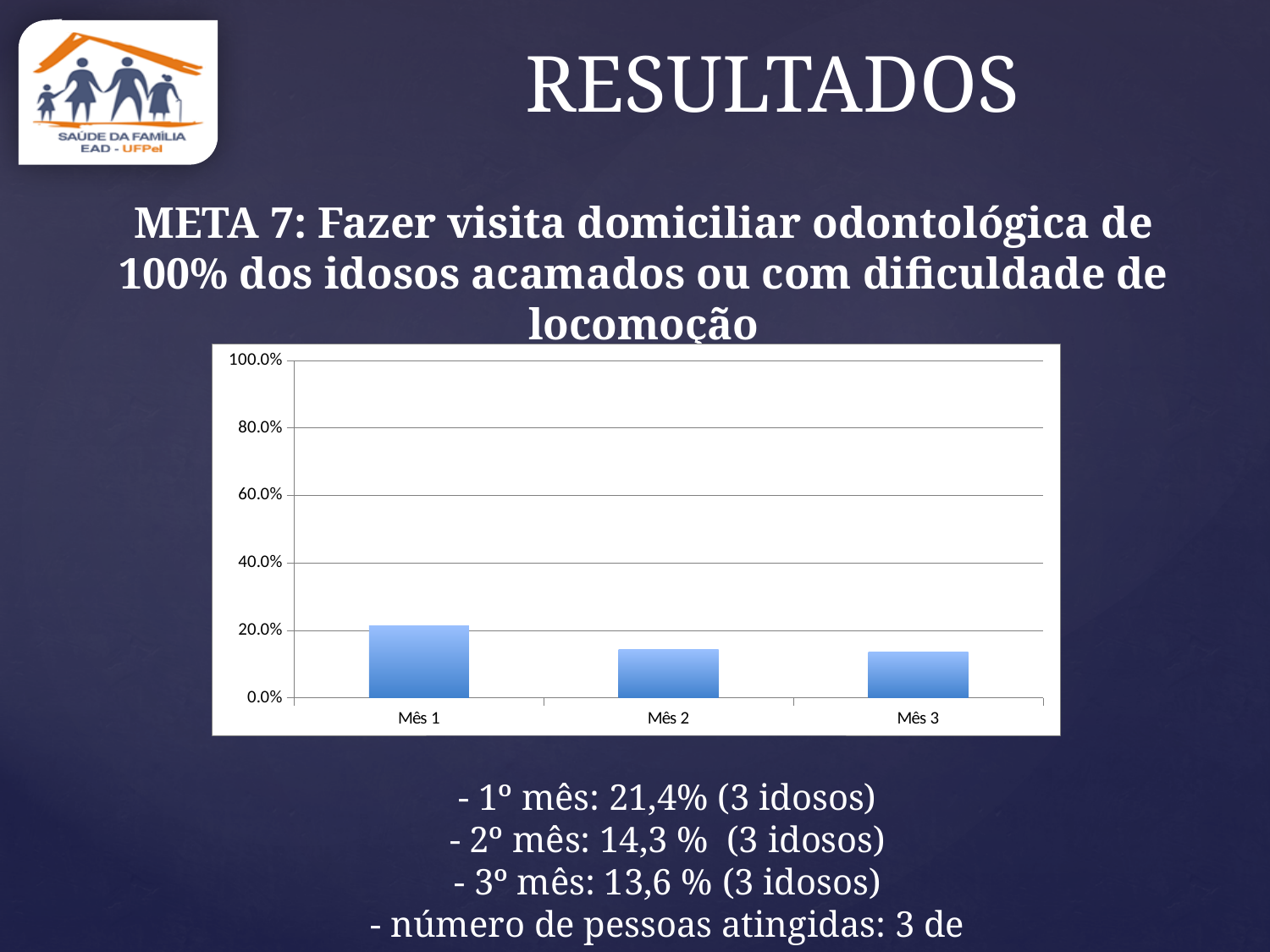
Using the percentages printed below the chart, what is the difference between the 1º mês and the 2º mês values? 7,1% Which month has the highest bar in the chart? Mês 1 What kind of chart is shown on the slide? bar chart Is the value for Mês 1 greater or less than 40.0%? less According to the text below the chart, what percentage was reached in the 3º mês? 13,6 % Do the bar values rise or fall from Mês 1 to Mês 3? fall What is the highest value shown on the chart's y axis? 100.0% Is the value for Mês 3 greater or less than 20.0%? less Which is larger, the value for Mês 1 or the value for Mês 2? Mês 1 According to the text below the chart, what percentage was reached in the 1º mês? 21,4% How many months (categories) are plotted on the x axis of the chart? 3 Is the value for Mês 2 greater or less than 20.0%? less